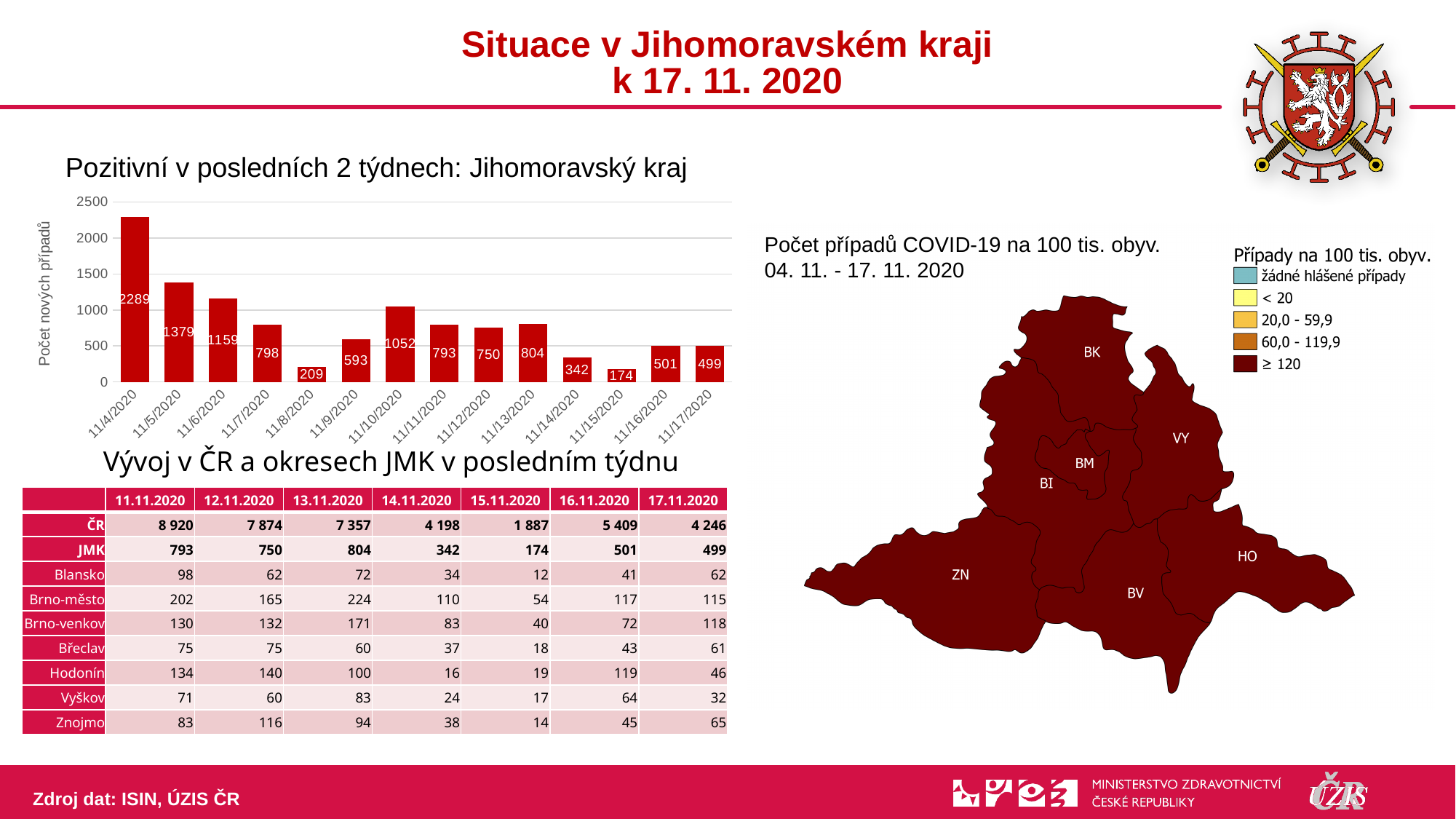
In the bar chart, what is the value for 11/10/2020? 1052 Which date has the lowest bar in the bar chart? 11/15/2020 What type of chart is shown under the title 'Pozitivní v posledních 2 týdnech: Jihomoravský kraj'? bar chart In the bar chart, what is the value for 11/4/2020? 2289 Overall, do the values in the bar chart rise or fall from 11/4/2020 to 11/17/2020? fall In the bar chart, what is the difference between the values for 11/4/2020 and 11/5/2020? 910 In the bar chart, what is the value for 11/17/2020? 499 What is the label on the vertical axis of the bar chart? Počet nových případů How many bars (dates) are shown in the bar chart? 14 In the bar chart, which is larger: the value for 11/13/2020 or 11/12/2020? 11/13/2020 Which date has the highest bar in the bar chart? 11/4/2020 In the bar chart, is the value for 11/8/2020 greater or less than 500? less